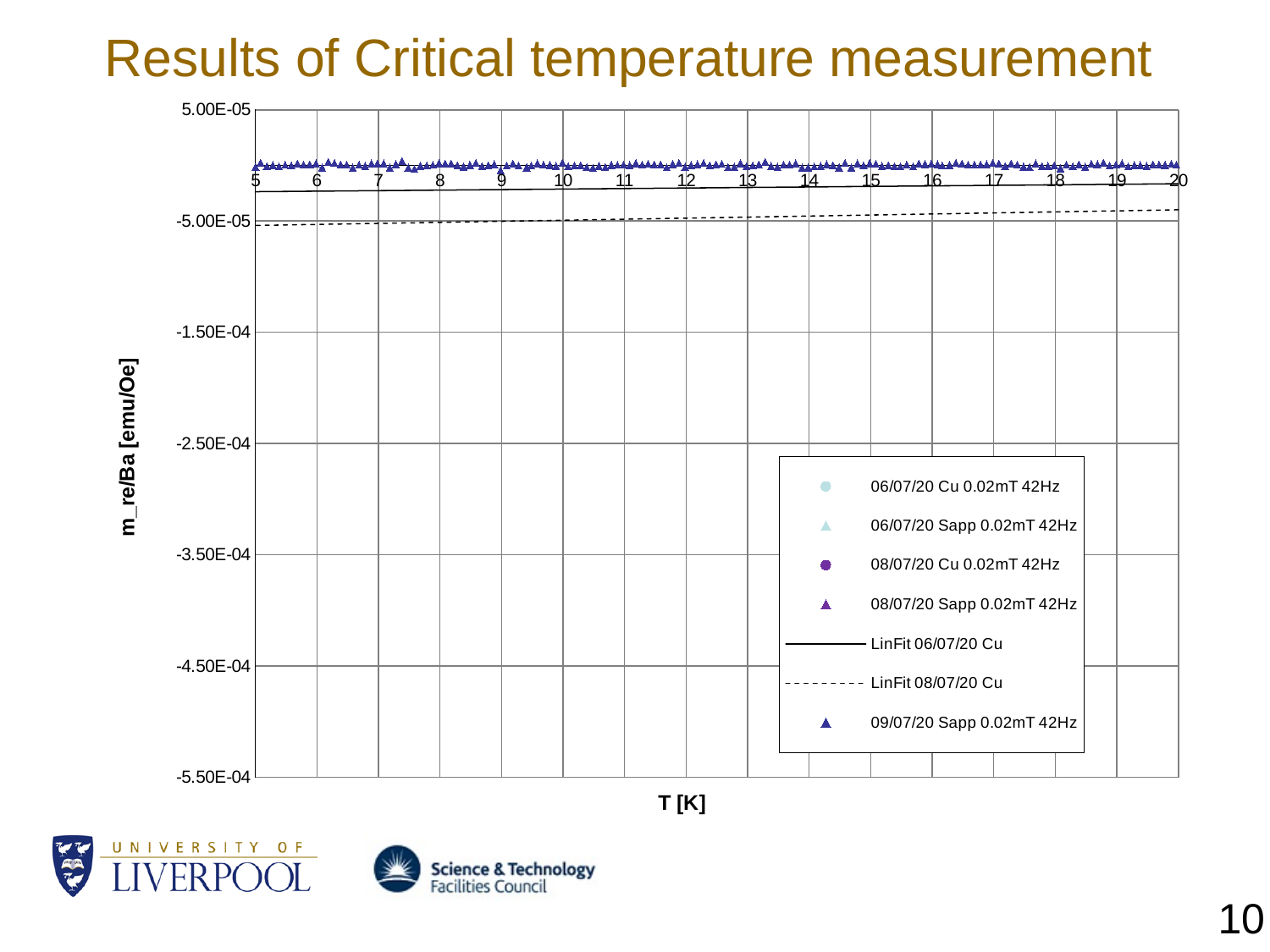
Is the value of the LinFit 06/07/20 Cu line at T = 5 greater or less than -1.50E-04? greater Is the value of the LinFit 08/07/20 Cu line at T = 20 greater or less than -5.00E-05? greater Which is larger at T = 15: the LinFit 06/07/20 Cu line or the LinFit 08/07/20 Cu line? LinFit 06/07/20 Cu Is the value of the 09/07/20 Sapp 0.02mT 42Hz series at T = 10 greater or less than -5.00E-05? greater What kind of chart is shown on the slide? scatter chart What is the lowest value shown on the y axis? -5.50E-04 How many series does the legend list? 7 What is the label of the x axis? T [K] How many legend entries are linear fits (LinFit)? 2 What is the highest value shown on the y axis? 5.00E-05 What is the title of the chart? Results of Critical temperature measurement Does the LinFit 08/07/20 Cu dashed line rise or fall as T increases from 5 to 20? rise